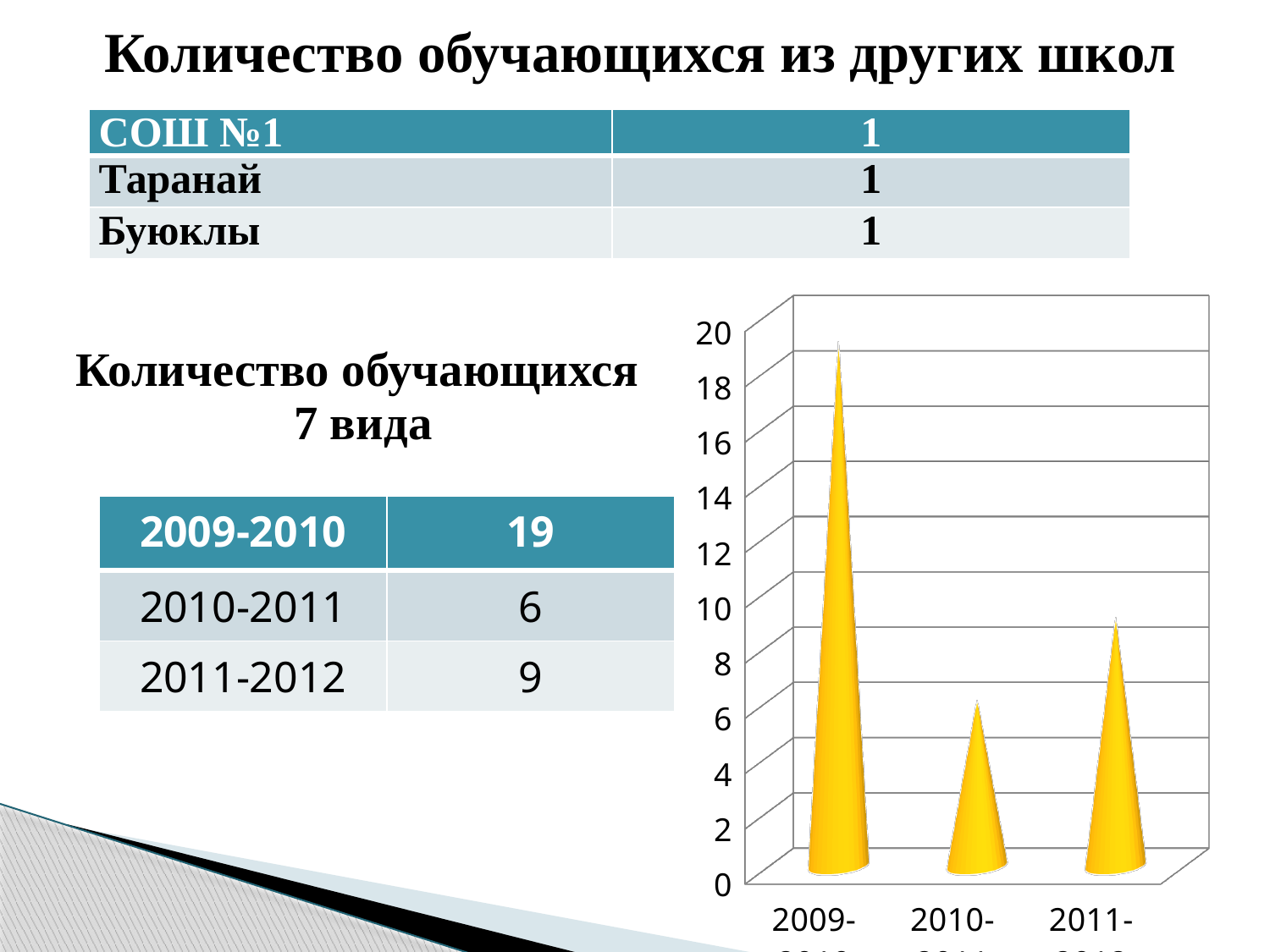
Is the value for 2010-2011 greater or less than 8? less What is the difference between the values for 2009-2010 and 2010-2011? 13 What is the value for 2009-2010 on the chart? 19 Which is larger on the chart, the value for 2011-2012 or the value for 2010-2011? 2011-2012 Is the value for 2009-2010 greater or less than 16? greater What is the value for 2011-2012 on the chart? 9 Which school year has the highest value on the chart? 2009-2010 What kind of chart is shown on the slide? bar chart How many categories (school years) are plotted on the chart? 3 Which school year has the lowest value on the chart? 2010-2011 What is the value for 2010-2011 on the chart? 6 What is the difference between the values for 2011-2012 and 2010-2011? 3